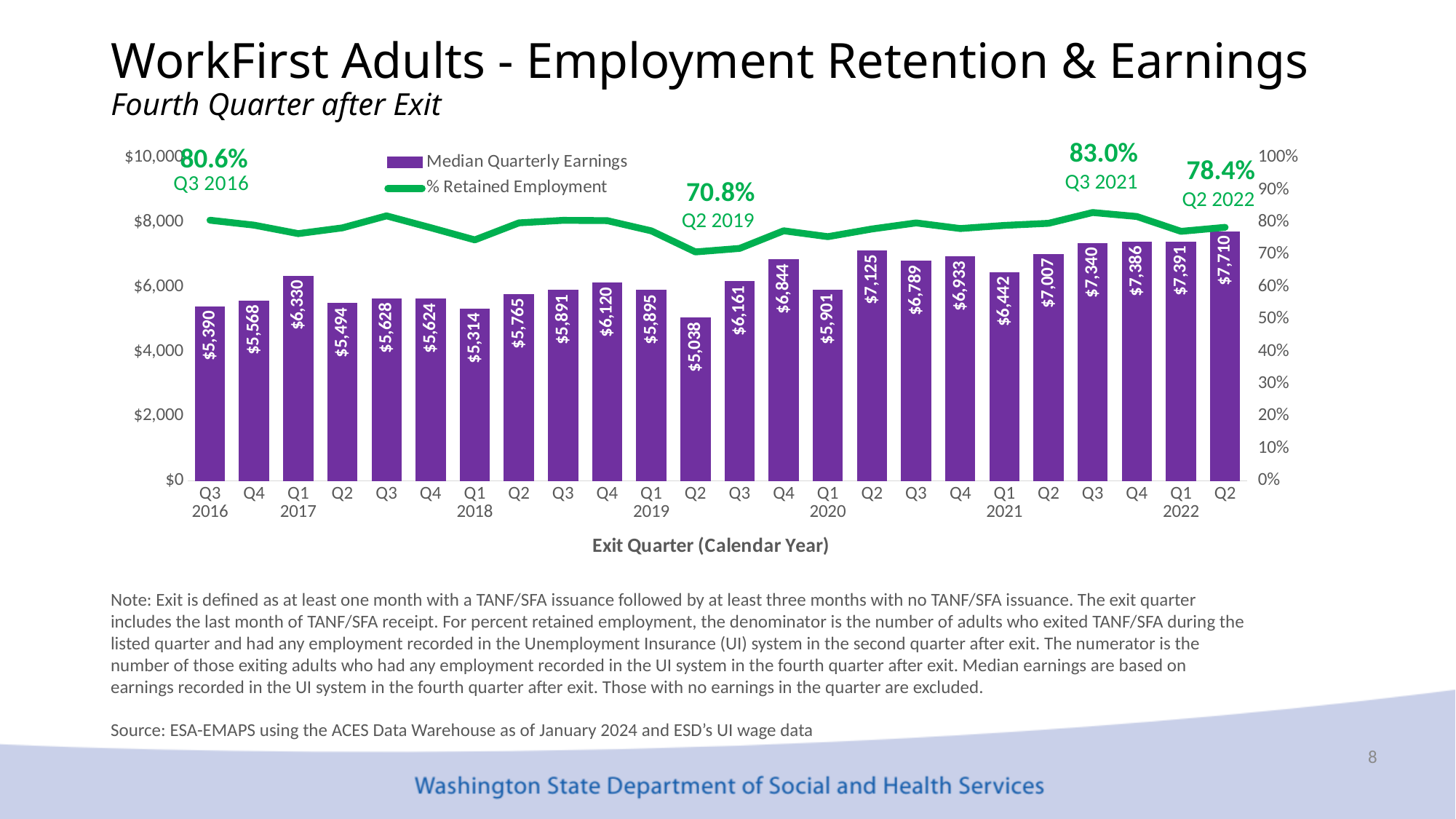
Which has higher Median Quarterly Earnings, Q4 2019 or Q1 2020? Q4 2019 What is the Median Quarterly Earnings value for Q1 2017? $6,330 How many exit quarters are shown on the x axis? 24 How many series does the legend list? 2 What is the Median Quarterly Earnings value for Q2 2022? $7,710 Which exit quarter has the highest Median Quarterly Earnings? Q2 2022 What is the % Retained Employment value labelled for Q2 2019? 70.8% Which exit quarter has the lowest Median Quarterly Earnings? Q2 2019 What is the difference in Median Quarterly Earnings between Q2 2022 and Q3 2016? $2,320 What is the % Retained Employment value labelled for Q3 2021? 83.0% What kind of chart is shown on the slide? Combined bar and line chart Is the % Retained Employment value for Q1 2018 greater or less than 80%? less